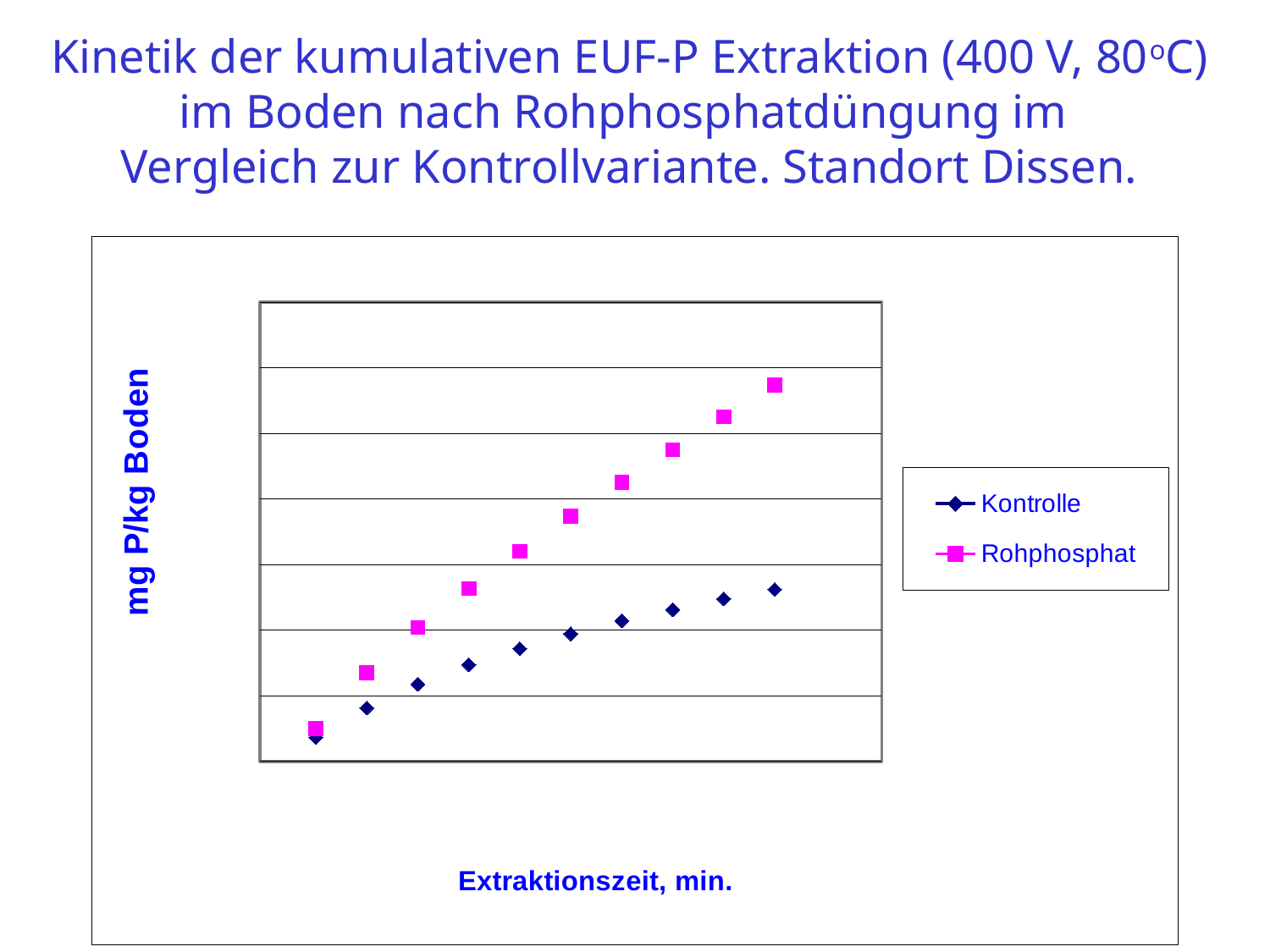
Do the Rohphosphat values rise or fall as extraction time increases along the x axis? rise Do the Kontrolle values rise or fall as extraction time increases along the x axis? rise How many series does the legend list? 2 Which series has the lowest plotted value on the chart? Kontrolle How many data points are plotted for the Kontrolle series? 10 Which series has the highest plotted value on the chart? Rohphosphat What is the label on the vertical axis? mg P/kg Boden How many data points are plotted for the Rohphosphat series? 10 What are the two series named in the legend? Kontrolle and Rohphosphat Which series reaches the higher value at the last extraction time point, Kontrolle or Rohphosphat? Rohphosphat What kind of chart is shown on the slide? scatter chart